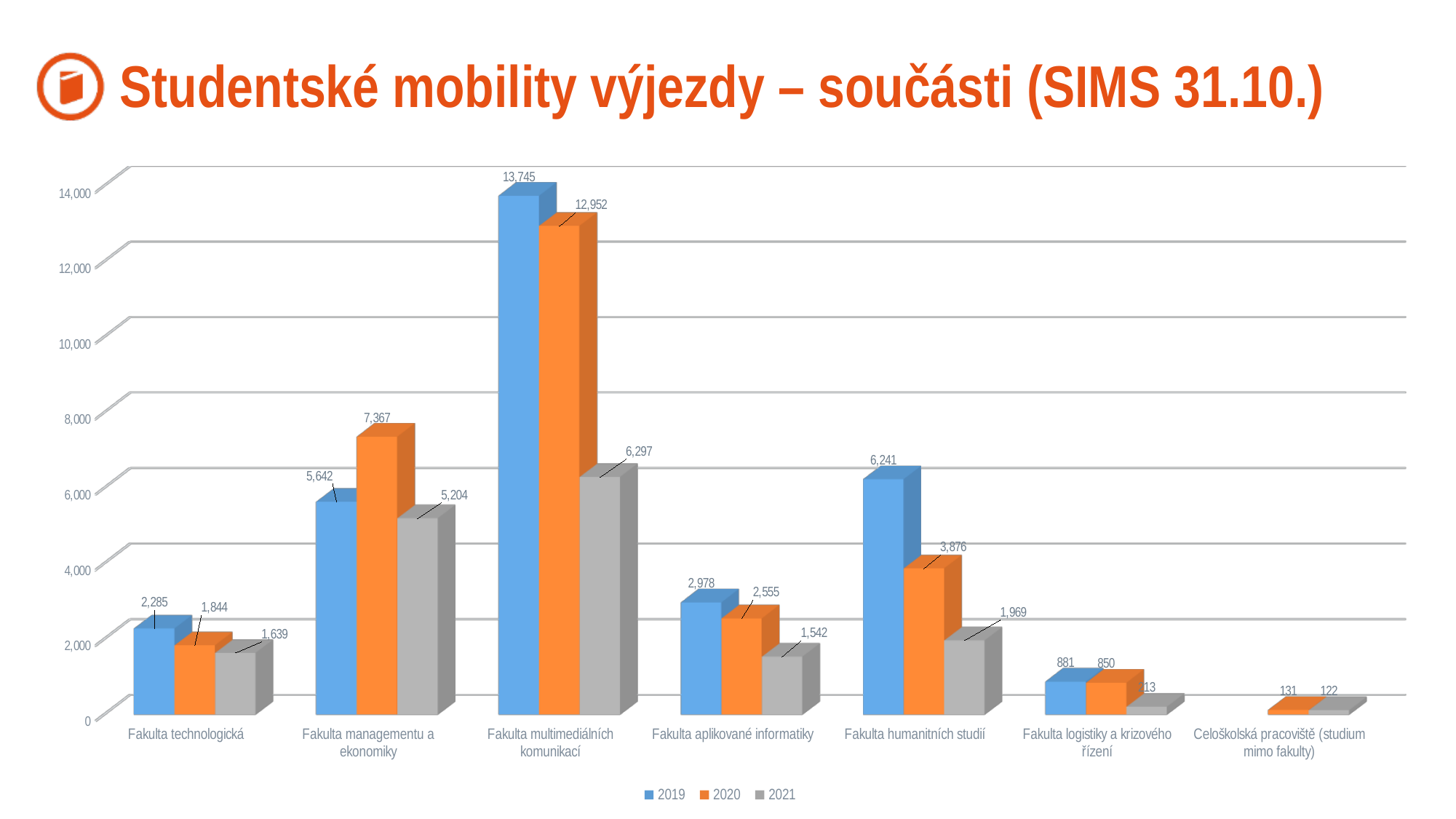
What is the 2021 value for Fakulta humanitních studií? 1,969 Is the 2021 value for Fakulta multimediálních komunikací greater or less than 6,000? greater What is the 2020 value for Fakulta managementu a ekonomiky? 7,367 What is the difference between the 2019 and 2020 values for Fakulta humanitních studií? 2,365 How many series does the legend list? 3 How many categories are shown on the x axis? 7 Which category has the lowest 2021 value? Celoškolská pracoviště (studium mimo fakulty) For Fakulta managementu a ekonomiky, which is larger: the 2019 value or the 2020 value? 2020 Which category has the highest 2019 value? Fakulta multimediálních komunikací What is the 2019 value for Fakulta multimediálních komunikací? 13,745 What kind of chart is shown on the slide? bar chart What is the 2020 value for Celoškolská pracoviště (studium mimo fakulty)? 131